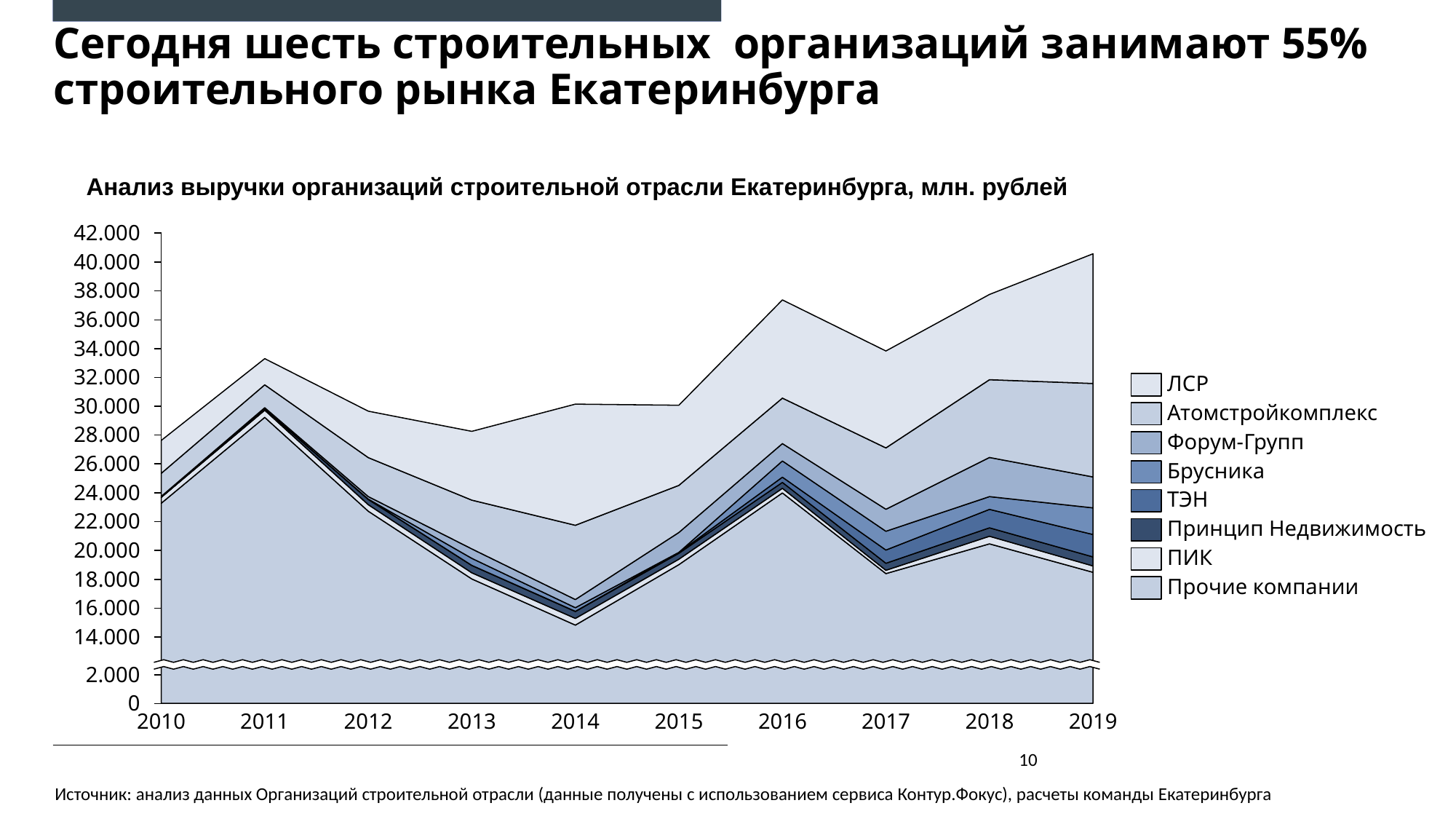
Is the total revenue in 2016 greater or less than 36.000? greater What is the title of the chart? Анализ выручки организаций строительной отрасли Екатеринбурга, млн. рублей In which year is the total revenue (top of the stacked area) lowest? 2014 How many series does the chart's legend list? 8 How many years are shown along the x axis of the chart? 10 Which year has the larger total revenue, 2011 or 2012? 2011 Which series is listed first in the chart's legend? ЛСР Is the total revenue in 2011 greater or less than 32.000? greater What kind of chart is shown on the slide? Stacked area chart Is the total revenue in 2014 greater or less than 24.000? less Does the total revenue rise or fall from 2017 to 2019? Rises In which year is the total revenue (top of the stacked area) highest? 2019